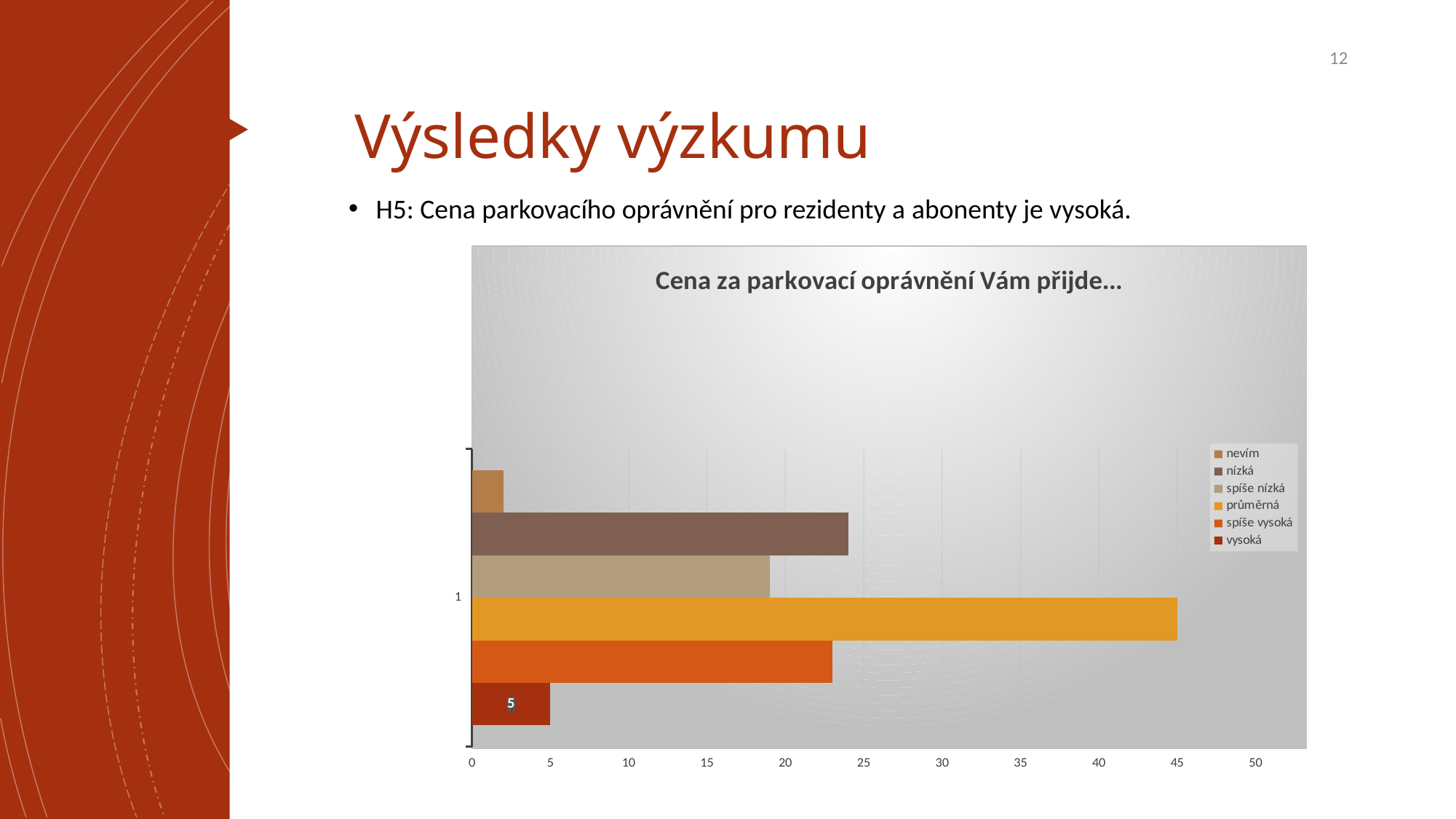
What is the value for the series "vysoká"? 5 What is the title of the chart? Cena za parkovací oprávnění Vám přijde... Which series has the shortest bar? nevím Which series is listed first in the chart legend? nevím Which is larger, the value for "nízká" or the value for "spíše nízká"? nízká What kind of chart is shown on the slide? bar chart Is the value for "průměrná" greater or less than 40? greater Which is larger, the value for "spíše vysoká" or the value for "spíše nízká"? spíše vysoká Is the value for "nevím" greater or less than 5? less How many series does the chart legend list? 6 Is the value for "nízká" greater or less than 20? greater Which series has the longest bar? průměrná